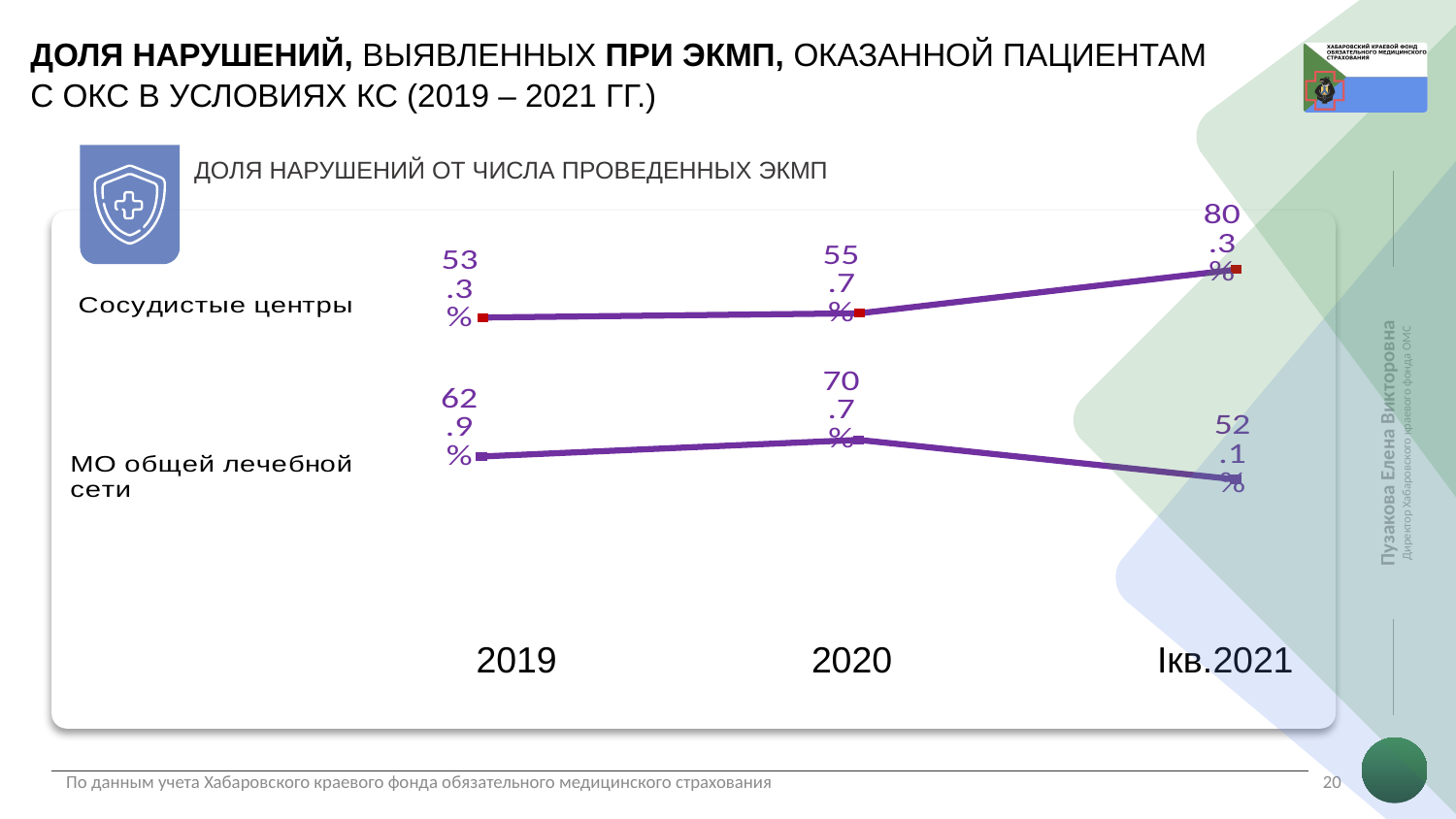
What is the value for Сосудистые центры in Iкв.2021? 80.3% Which is larger in 2019: the value for Сосудистые центры or for МО общей лечебной сети? МО общей лечебной сети What is the difference between the МО общей лечебной сети values for 2020 and 2019? 7.8% What is the value for Сосудистые центры in 2019? 53.3% What is the value for МО общей лечебной сети in Iкв.2021? 52.1% Do the values for Сосудистые центры rise or fall from 2019 to Iкв.2021? Rise What kind of chart is used to show the share of violations? Line chart What is the difference between the Сосудистые центры values for Iкв.2021 and 2020? 24.6% In which period is the value for МО общей лечебной сети lowest? Iкв.2021 What is the value for МО общей лечебной сети in 2020? 70.7% How many time periods are shown on the x axis? 3 In which period is the value for Сосудистые центры highest? Iкв.2021